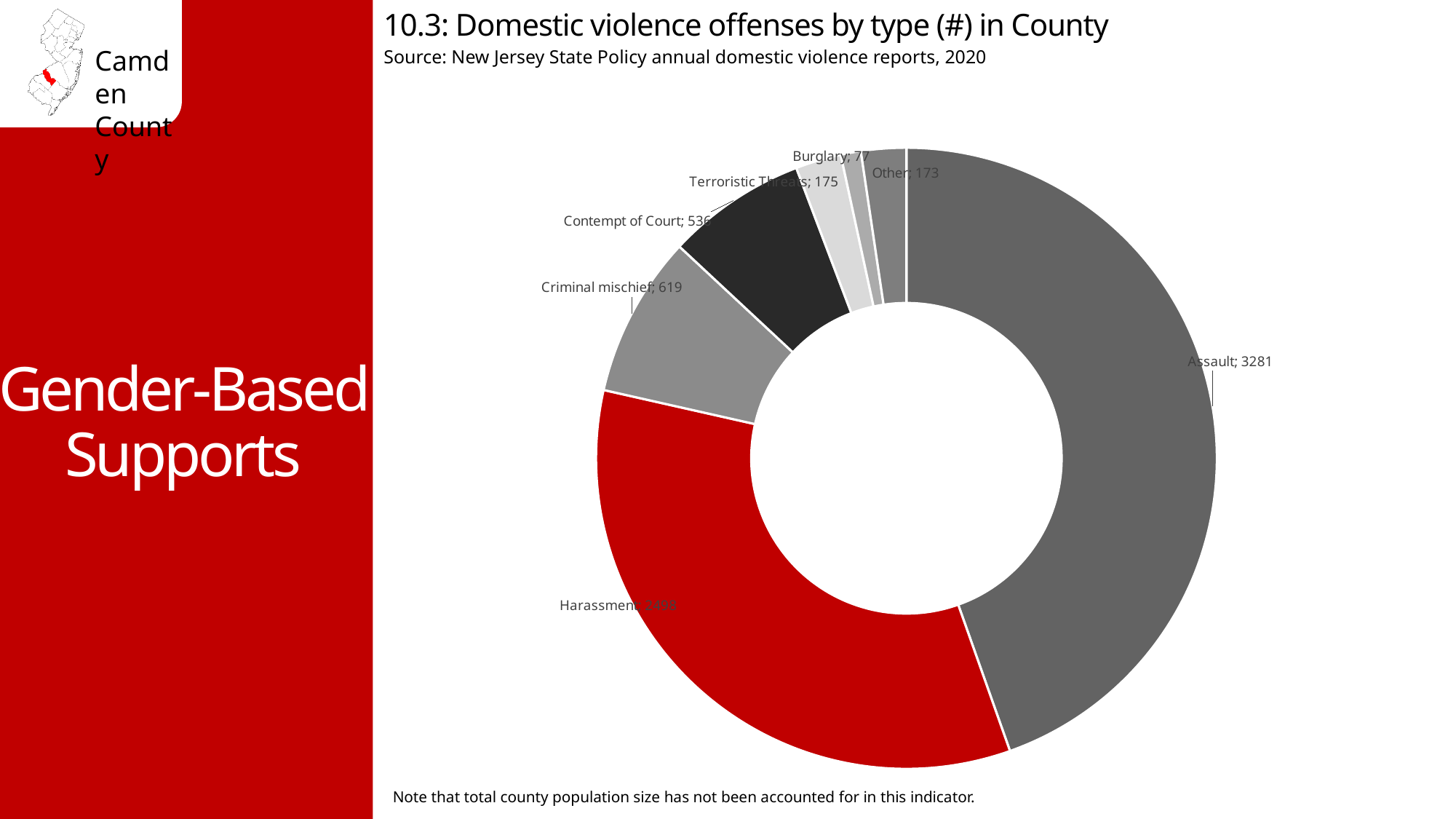
What is the difference between the values for Criminal mischief and Contempt of Court? 83 Which offense type has the highest number of offenses? Assault What is the value for Terroristic Threats? 175 Which is larger, the value for Criminal mischief or the value for Contempt of Court? Criminal mischief How many offense types are shown in the chart? 7 What is the value for Contempt of Court? 536 What is the value for the Other category? 173 Which offense type has the lowest number of offenses? Burglary What kind of chart is shown on the slide? doughnut chart How many domestic violence offenses of type Assault are shown? 3281 What is the value for Criminal mischief? 619 What is the value for Burglary? 77